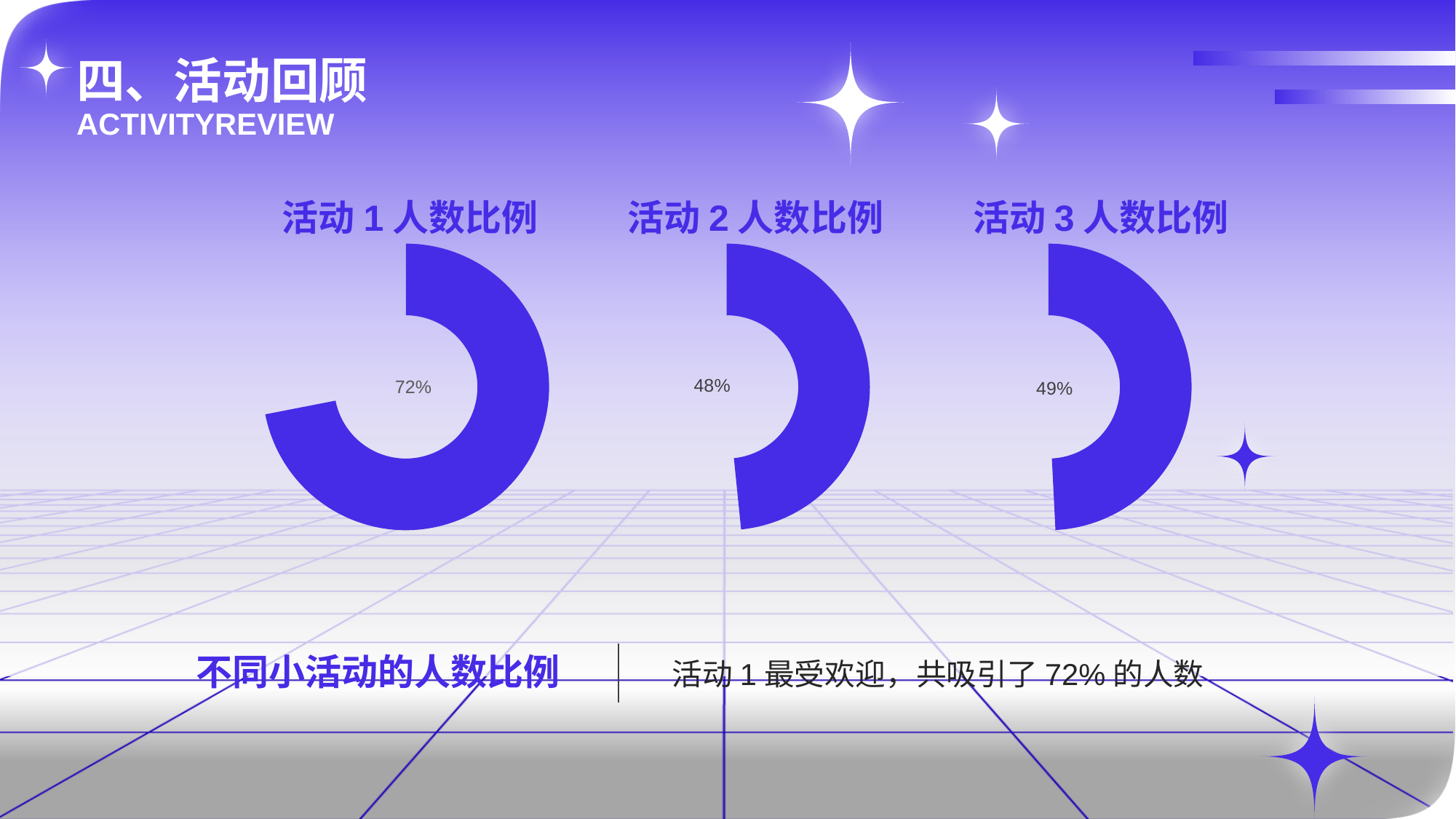
In the chart titled 活动 1 人数比例, is the labelled value greater or less than 50%? greater Across the three charts on the slide, which activity has the highest labelled percentage? 活动 1 Comparing the charts 活动 1 人数比例 and 活动 2 人数比例, which shows the larger percentage? 活动 1 人数比例 In the chart titled 活动 3 人数比例, what percentage is shown by the data label? 49% Across the three charts on the slide, which activity has the lowest labelled percentage? 活动 2 What is the difference in percentage points between the value in the 活动 1 人数比例 chart and the value in the 活动 2 人数比例 chart? 24 percentage points In the chart titled 活动 2 人数比例, what percentage is shown by the data label? 48% How many charts are shown on the slide? 3 What is the title of the chart positioned in the middle of the slide? 活动 2 人数比例 What kind of chart is used for 活动 1 人数比例? Doughnut chart In the chart titled 活动 1 人数比例, what percentage is shown by the data label? 72% What is the difference in percentage points between the value in the 活动 3 人数比例 chart and the value in the 活动 2 人数比例 chart? 1 percentage point